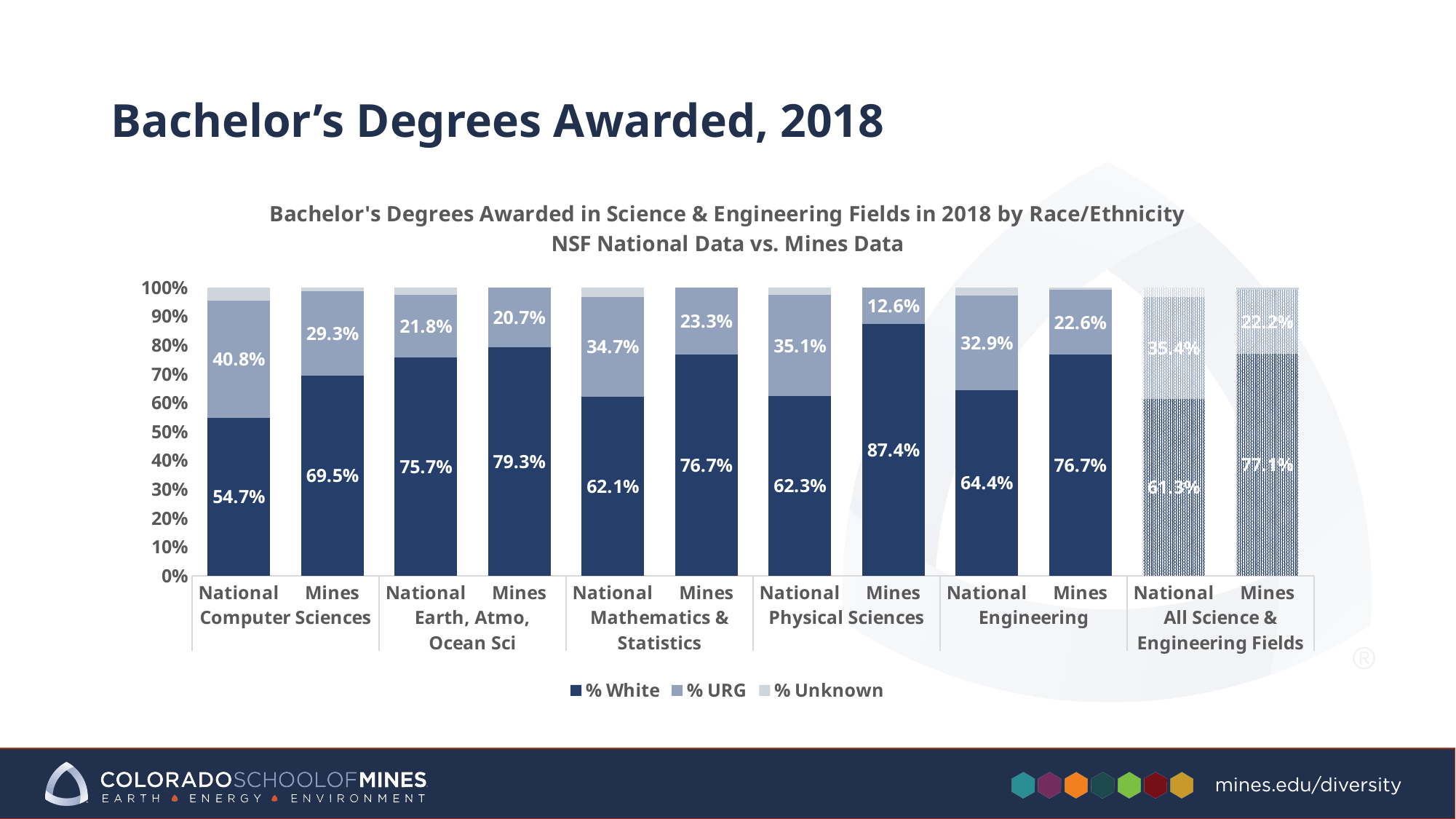
Which bar has the highest % URG value? National, Computer Sciences (40.8%) What is the % URG value for the Mines bar in Engineering? 22.6% What is the % White value for the Mines bar in Physical Sciences? 87.4% What is the % White value for the Mines bar in Computer Sciences? 69.5% Which has a larger % White value in Mathematics & Statistics, National or Mines? Mines How many bars are plotted in the chart? 12 What is the % URG value for the National bar in Computer Sciences? 40.8% Which bar has the highest % White value? Mines, Physical Sciences (87.4%) Which bar has the lowest % URG value? Mines, Physical Sciences (12.6%) How many series does the legend list? 3 What kind of chart is shown on the slide? Stacked bar chart What is the difference in % White between the Mines and National bars in Engineering? 12.3 percentage points